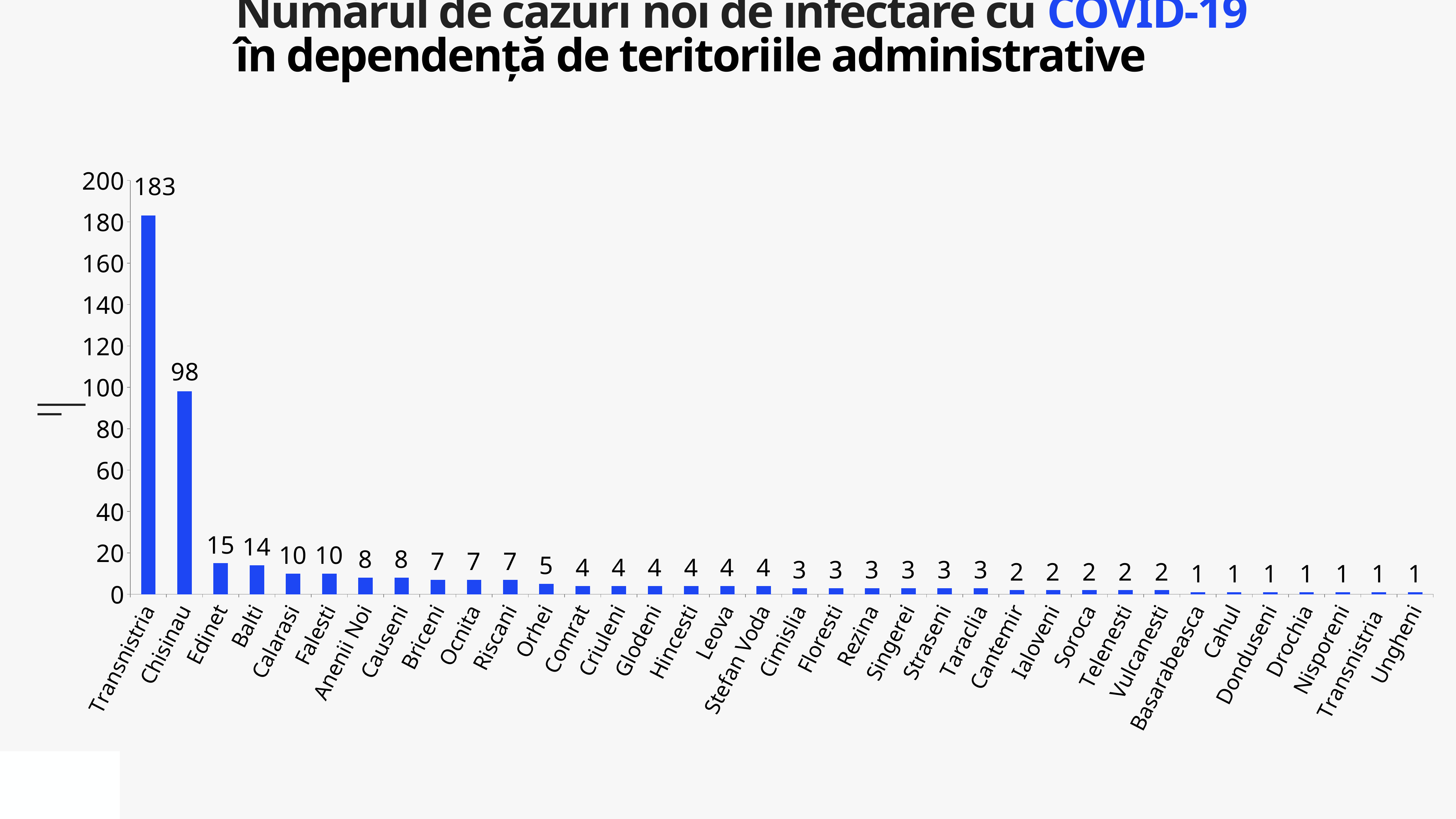
What is the difference between the values for Balti and Calarasi? 4 Is the value for Chisinau greater or less than 100? less What kind of chart is shown on the slide? Bar chart What is the difference between the values for Chisinau and Edinet? 83 Which category has the highest value? Transnistria What is the value for Orhei? 5 What is the value for Balti? 14 What is the value for Edinet? 15 Which is larger, the value for Anenii Noi or the value for Orhei? Anenii Noi How many categories are shown on the x axis? 36 What is the value for Ungheni? 1 What is the value for Chisinau? 98